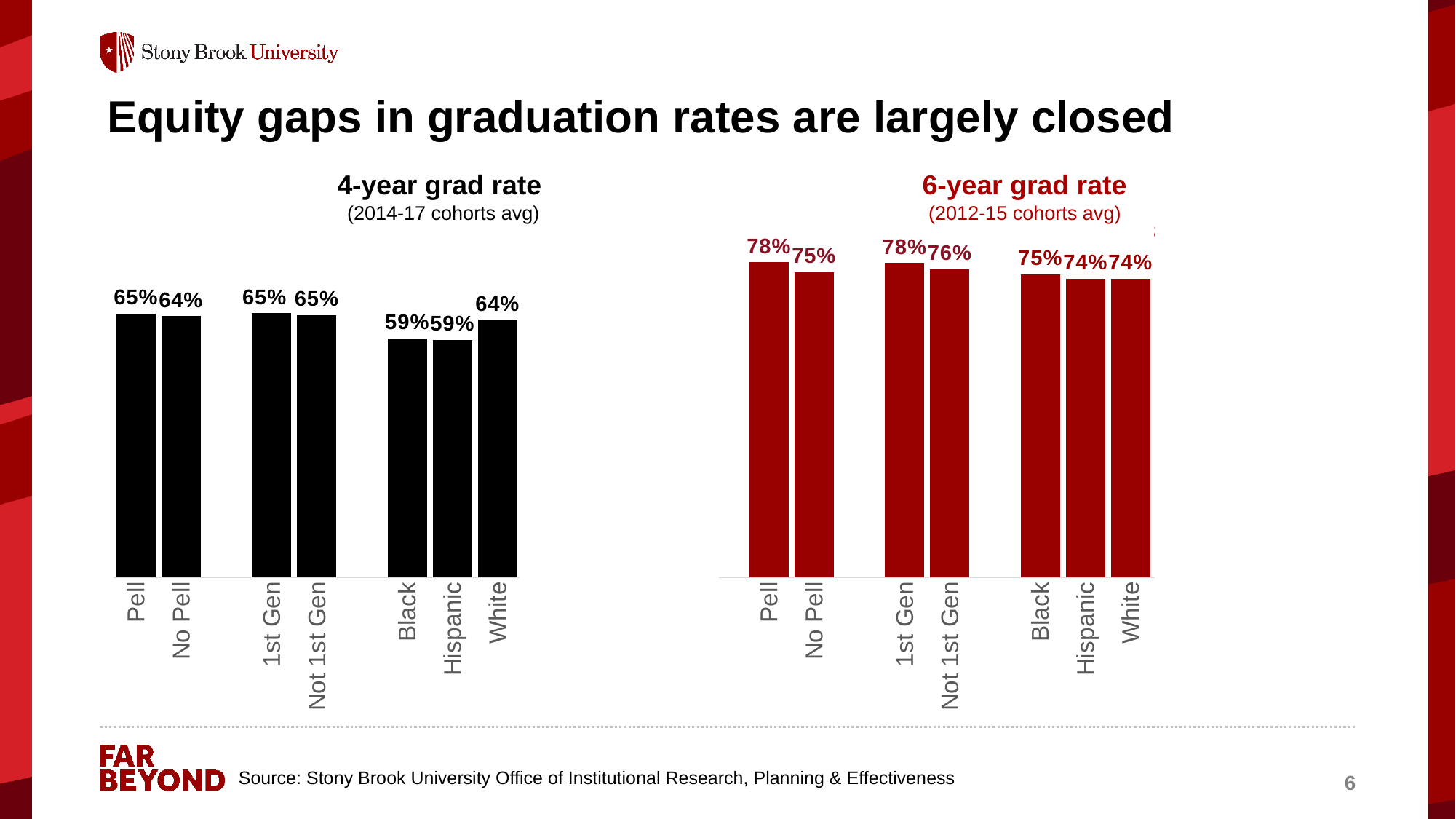
In the 6-year grad rate chart, what is the difference between Pell and No Pell? 3 percentage points In the 6-year grad rate chart, what is the value for Not 1st Gen? 76% In the 4-year grad rate chart, what is the value for Hispanic? 59% In the 4-year grad rate chart, which is larger, 1st Gen or Not 1st Gen? They are equal (65%) In the 6-year grad rate chart, what is the value for No Pell? 75% How many categories are shown in the 6-year grad rate chart? 7 In the 6-year grad rate chart, what is the value for White? 74% What type of chart is the 4-year grad rate chart? Bar chart In the 4-year grad rate chart, what is the value for Pell? 65% In the 4-year grad rate chart, which category has the lowest value? Black and Hispanic (59%) In the 4-year grad rate chart, what is the difference between White and Black? 5 percentage points In the 6-year grad rate chart, which categories share the highest value? Pell and 1st Gen (78%)